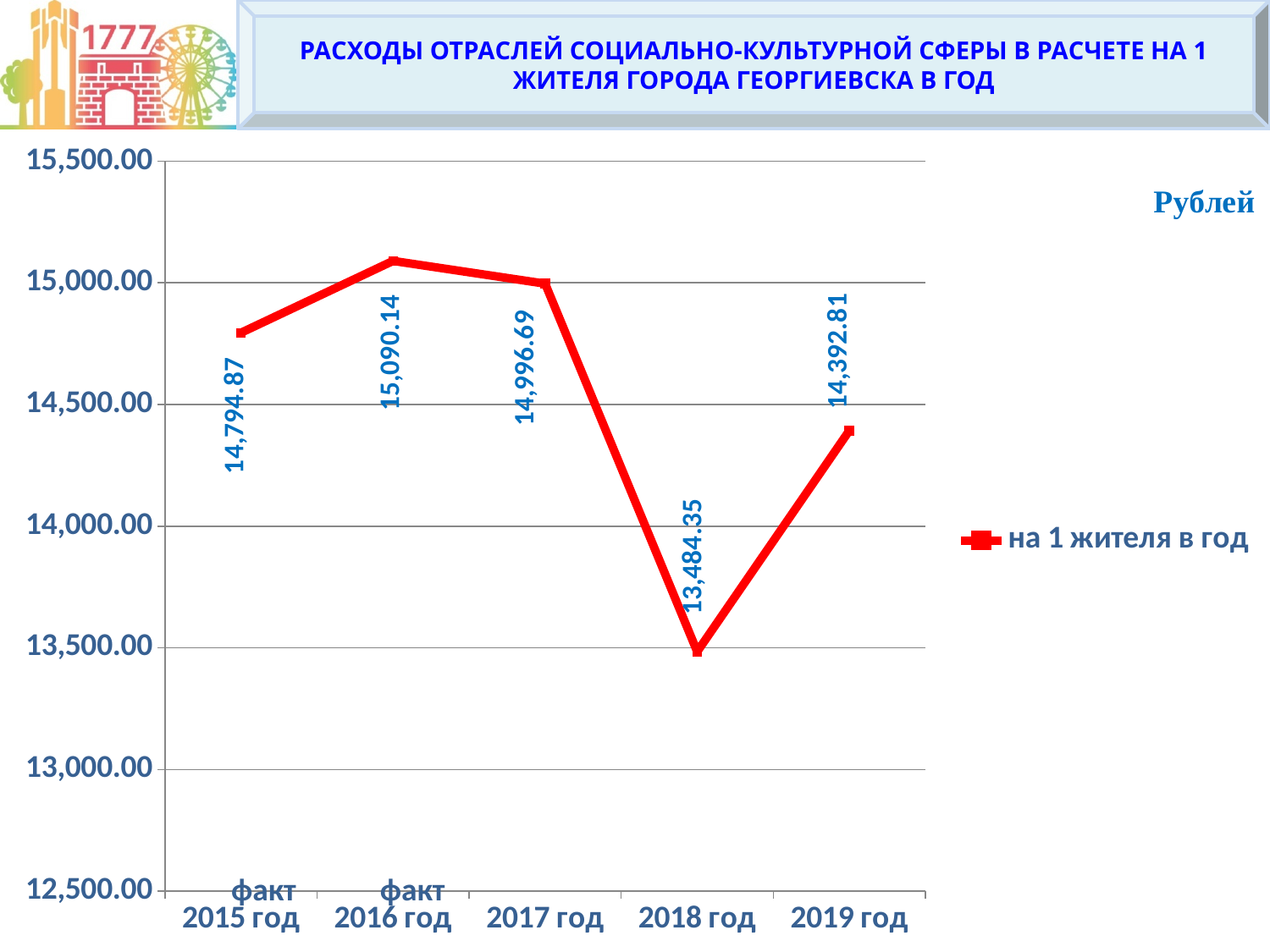
Which year has the highest value? 2016 год How many years are plotted on the chart? 5 What is the value for 2015 год (факт)? 14,794.87 Which year has the lowest value? 2018 год What series name does the legend show? на 1 жителя в год What is the value for 2016 год (факт)? 15,090.14 What is the difference between the values for 2016 год and 2015 год? 295.27 What is the value for 2019 год? 14,392.81 What is the difference between the values for 2017 год and 2018 год? 1,512.34 Which is larger, the value for 2017 год or the value for 2019 год? 2017 год What kind of chart is shown on the slide? line chart What is the value for 2018 год? 13,484.35